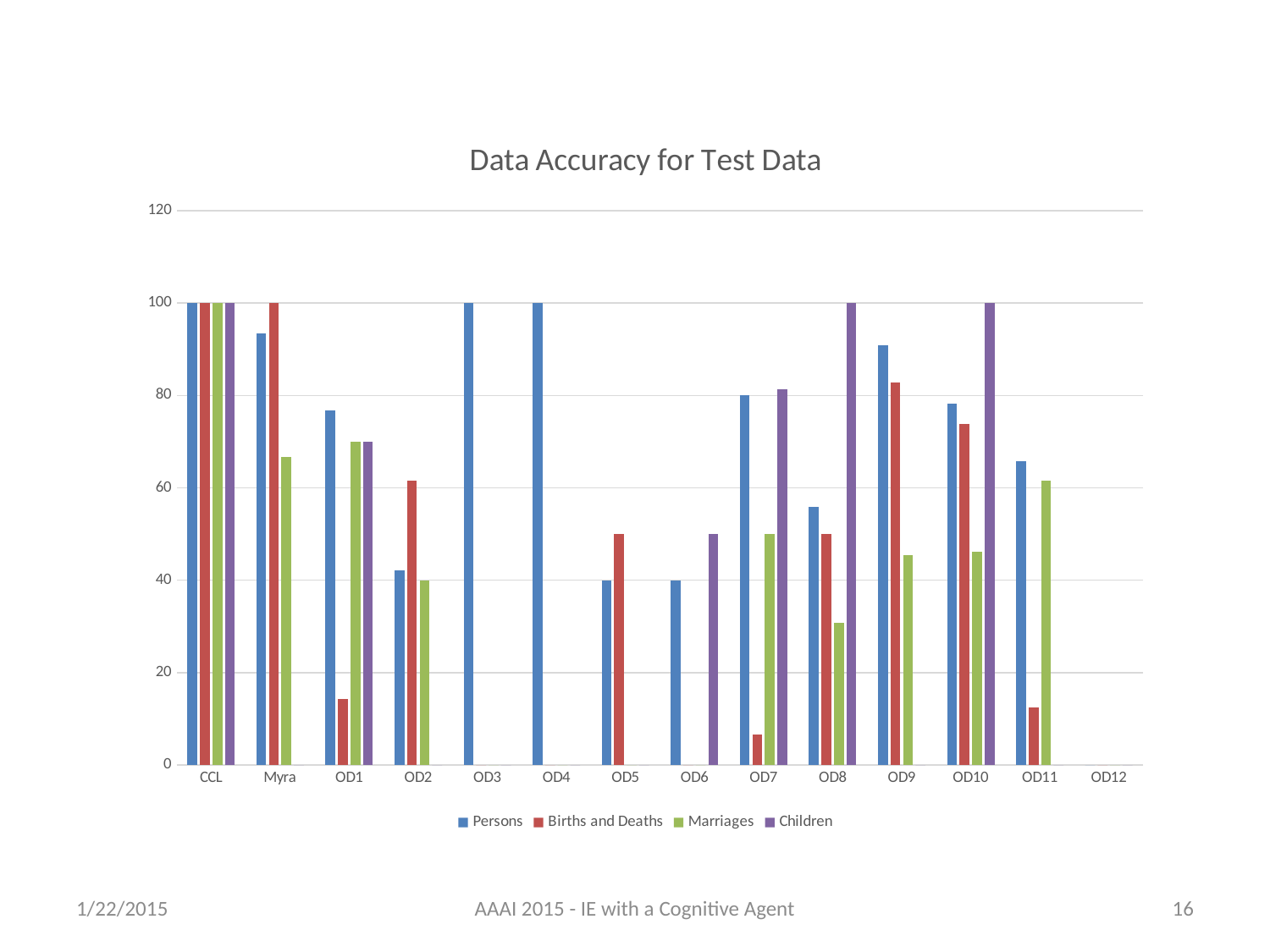
What is the Children value for OD8? 100 What is the Persons value for OD3? 100 How many categories are shown along the x axis? 14 Which is larger, the Persons value for OD9 or the Persons value for OD8? OD9 What is the title of the chart? Data Accuracy for Test Data How many series does the legend list? 4 Is the Persons value for OD9 greater or less than 80? greater What is the Births and Deaths value for Myra? 100 What kind of chart is shown on the slide? bar chart Is the Births and Deaths value for OD7 greater or less than 20? less Which category has the lowest Births and Deaths value among those with a bar? OD7 Is the Marriages value for OD8 greater or less than 40? less